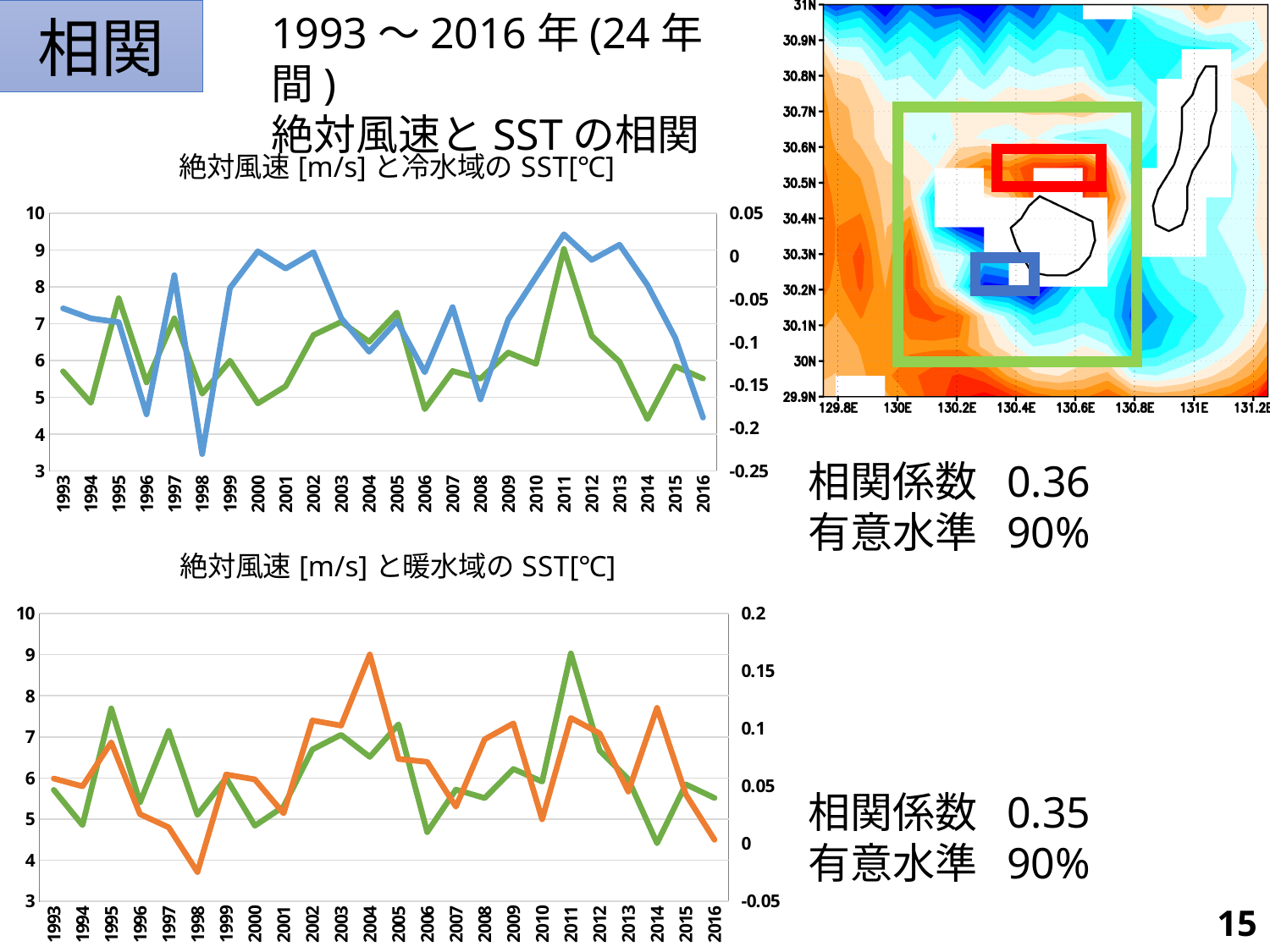
In the top chart (冷水域), in which year does the blue line reach its lowest value? 1998 In the top chart (冷水域), is the value of the green line in 2011 greater or less than 8 on the left axis? greater In the top chart (冷水域), is the value of the blue line in 1998 greater or less than 4 on the left axis? less What kind of chart is the top chart titled 絶対風速 [m/s] と冷水域の SST[℃]? line chart How many years are plotted along the x axis of the bottom chart titled 絶対風速 [m/s] と暖水域の SST[℃]? 24 What is the highest tick value shown on the right-hand axis of the bottom chart (暖水域)? 0.2 In the top chart (冷水域), is the green line's value higher in 2011 or in 1995? 2011 In the bottom chart (暖水域), in which year does the orange line reach its lowest value? 1998 In the bottom chart (暖水域), is the value of the orange line in 2016 greater or less than 5 on the left axis? less In the bottom chart (暖水域), is the orange line's value higher in 2004 or in 2014? 2004 In the top chart (冷水域), in which year does the green line reach its highest value? 2011 In the bottom chart (暖水域), in which year does the orange line reach its highest value? 2004